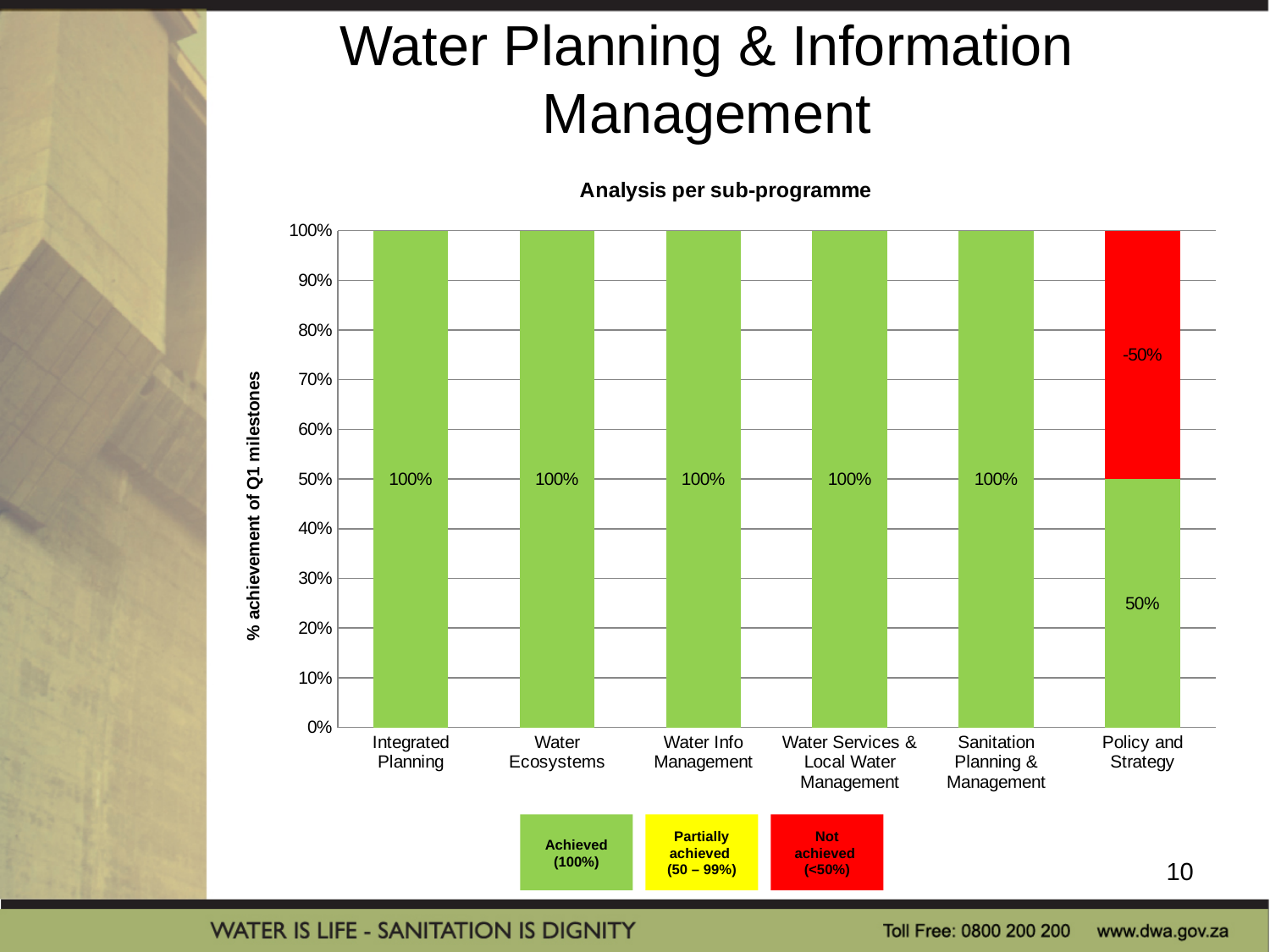
What is the value shown for Sanitation Planning & Management? 100% What is the difference between the green (achieved) value for Water Info Management and the green value for Policy and Strategy? 50% What is the title of the chart? Analysis per sub-programme What is the green (achieved) value shown for Policy and Strategy? 50% What is the label of the y axis? % achievement of Q1 milestones How many sub-programmes show a green (achieved) value of 100%? 5 What is the green (achieved) value shown for Integrated Planning? 100% Which is larger, the green (achieved) value for Water Ecosystems or for Policy and Strategy? Water Ecosystems What value is printed on the red segment of the Policy and Strategy bar? -50% How many sub-programme categories are shown on the x axis of the chart? 6 What type of chart is shown on the slide? bar chart Which sub-programme has the lowest green (achieved) value? Policy and Strategy